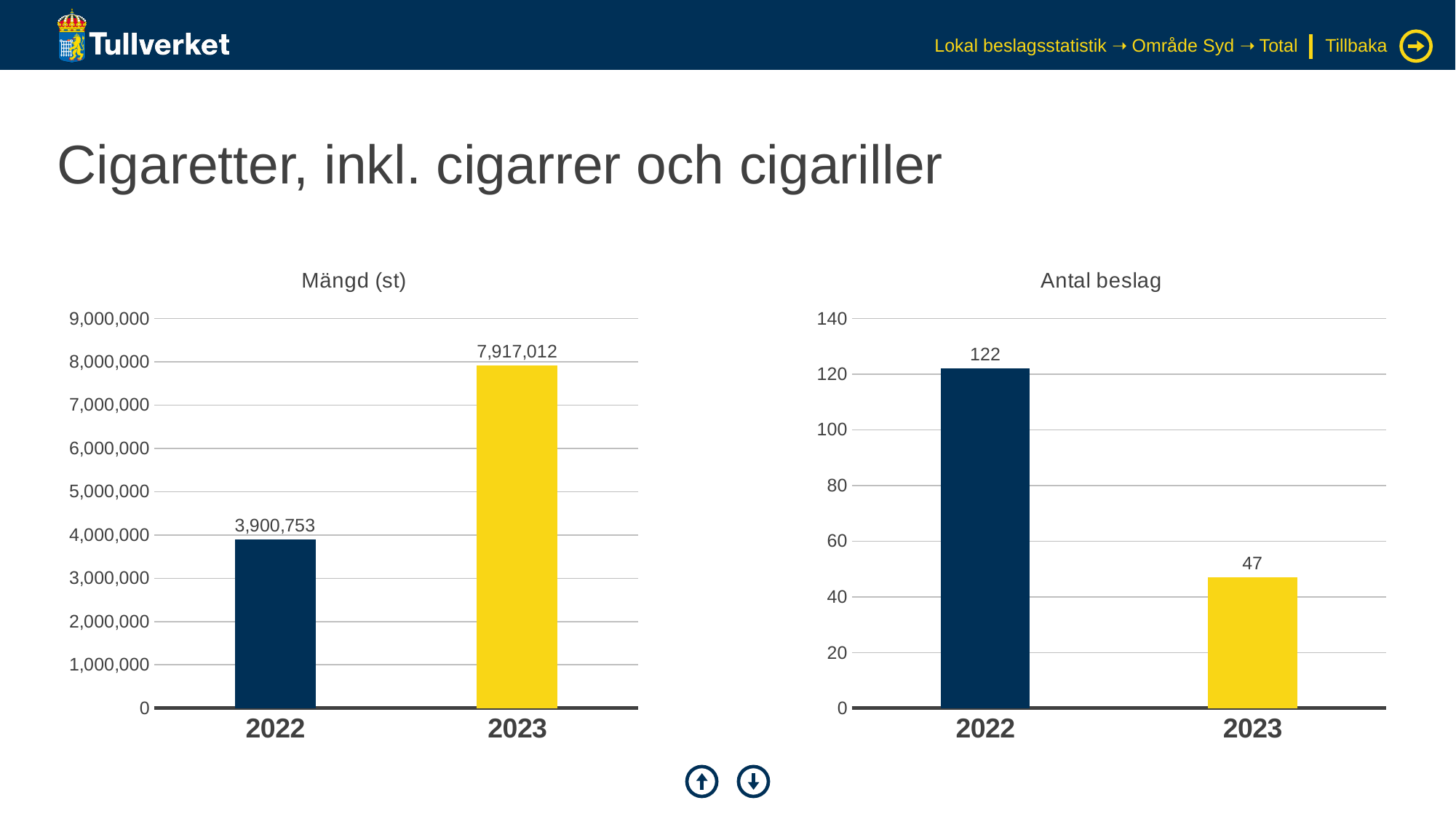
In the "Antal beslag" chart, what is the value for 2022? 122 In the "Antal beslag" chart, which year has the lowest value? 2023 In the "Mängd (st)" chart, do the values rise or fall from 2022 to 2023? rise In the "Mängd (st)" chart, what is the value for 2022? 3,900,753 In the "Antal beslag" chart, what is the difference between the 2022 and 2023 values? 75 How many categories are shown on the x axis of the "Mängd (st)" chart? 2 In the "Antal beslag" chart, is the value for 2022 larger or smaller than the value for 2023? larger What kind of chart is the "Antal beslag" chart? bar chart In the "Mängd (st)" chart, what is the difference between the 2023 and 2022 values? 4,016,259 In the "Mängd (st)" chart, what is the value for 2023? 7,917,012 In the "Antal beslag" chart, what is the value for 2023? 47 In the "Mängd (st)" chart, which year has the highest value? 2023